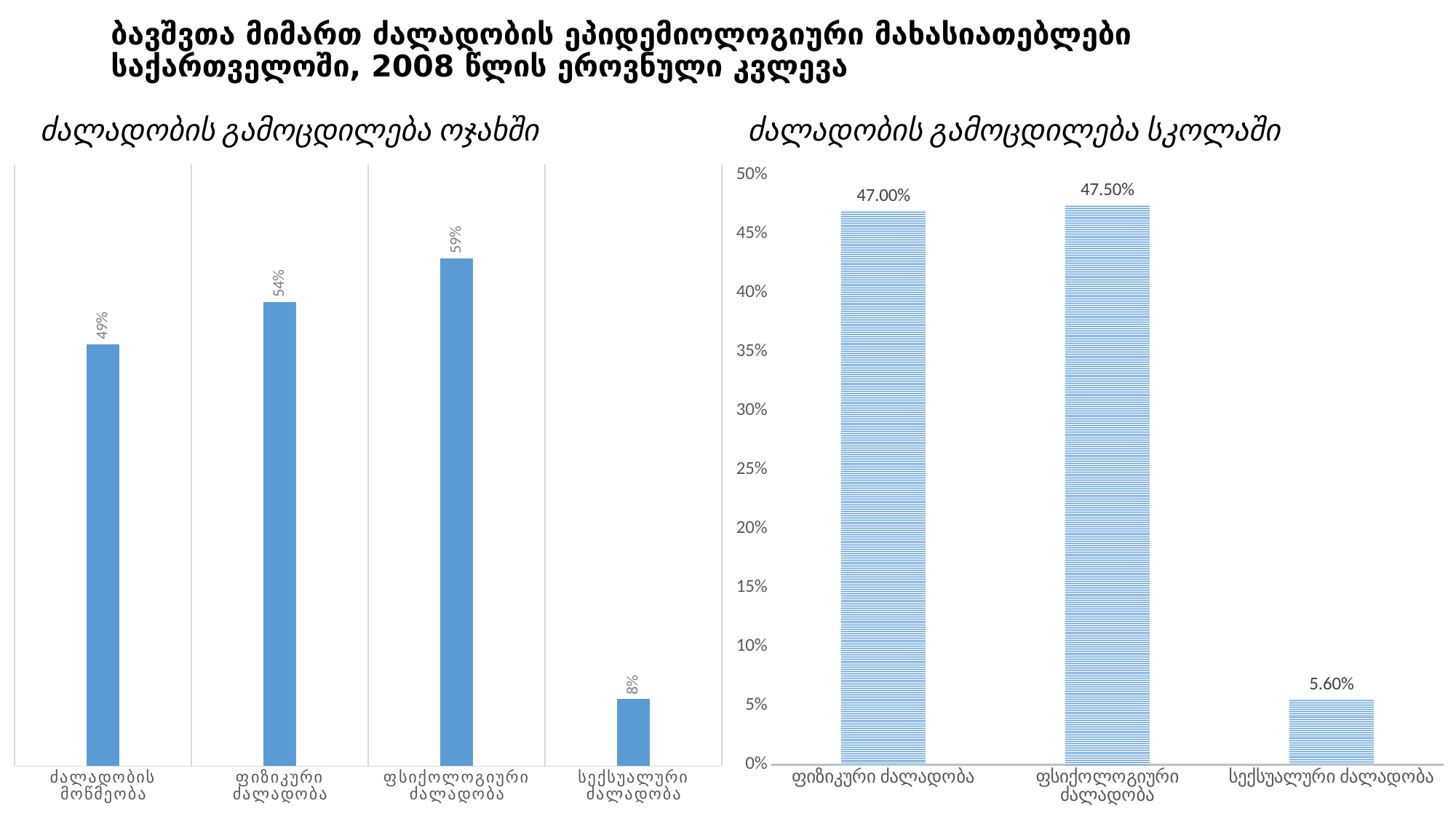
In the chart titled "ძალადობის გამოცდილება ოჯახში", what is the difference between ფსიქოლოგიური ძალადობა and ფიზიკური ძალადობა? 5% In the chart titled "ძალადობის გამოცდილება ოჯახში", which category has the highest value? ფსიქოლოგიური ძალადობა In the chart titled "ძალადობის გამოცდილება სკოლაში", what is the difference between ფსიქოლოგიური ძალადობა and ფიზიკური ძალადობა? 0.50% In the chart titled "ძალადობის გამოცდილება სკოლაში", is the value for ფიზიკური ძალადობა greater or less than 45%? greater In the chart titled "ძალადობის გამოცდილება ოჯახში", which category has the lowest value? სექსუალური ძალადობა In the chart titled "ძალადობის გამოცდილება ოჯახში", what is the value for ფსიქოლოგიური ძალადობა? 59% In the chart titled "ძალადობის გამოცდილება ოჯახში", how many categories are shown? 4 In the chart titled "ძალადობის გამოცდილება სკოლაში", what is the value for ფიზიკური ძალადობა? 47.00% In the chart titled "ძალადობის გამოცდილება სკოლაში", what is the value for სექსუალური ძალადობა? 5.60% What kind of chart is the chart titled "ძალადობის გამოცდილება სკოლაში"? bar chart In the chart titled "ძალადობის გამოცდილება ოჯახში", what is the value for ძალადობის მოწმეობა? 49% In the chart titled "ძალადობის გამოცდილება სკოლაში", which category has the lowest value? სექსუალური ძალადობა